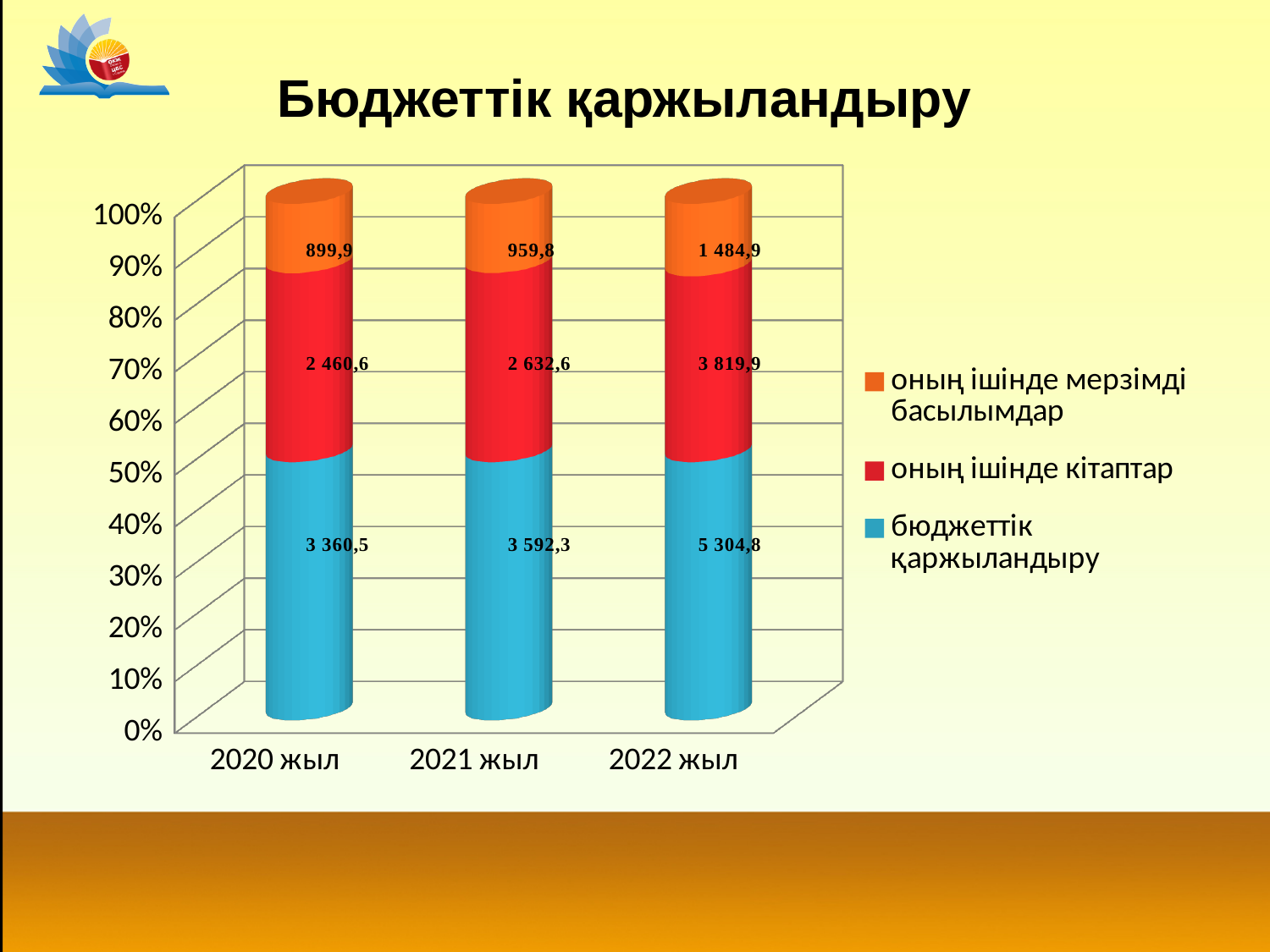
What is the value of бюджеттік қаржыландыру for 2021 жыл? 3 592,3 What is the value of оның ішінде мерзімді басылымдар for 2021 жыл? 959,8 Which year has the lowest value for бюджеттік қаржыландыру? 2020 жыл Which year has the highest value for оның ішінде мерзімді басылымдар? 2022 жыл Which is larger: оның ішінде кітаптар for 2021 жыл or for 2022 жыл? 2022 жыл What is the difference between the оның ішінде мерзімді басылымдар values for 2021 жыл and 2020 жыл? 59,9 What is the value of оның ішінде кітаптар for 2020 жыл? 2 460,6 What is the value of бюджеттік қаржыландыру for 2022 жыл? 5 304,8 What is the difference between the оның ішінде кітаптар values for 2022 жыл and 2020 жыл? 1 359,3 How many series does the legend list? 3 What kind of chart is shown on the slide? Stacked bar chart How many years are shown on the x axis? 3